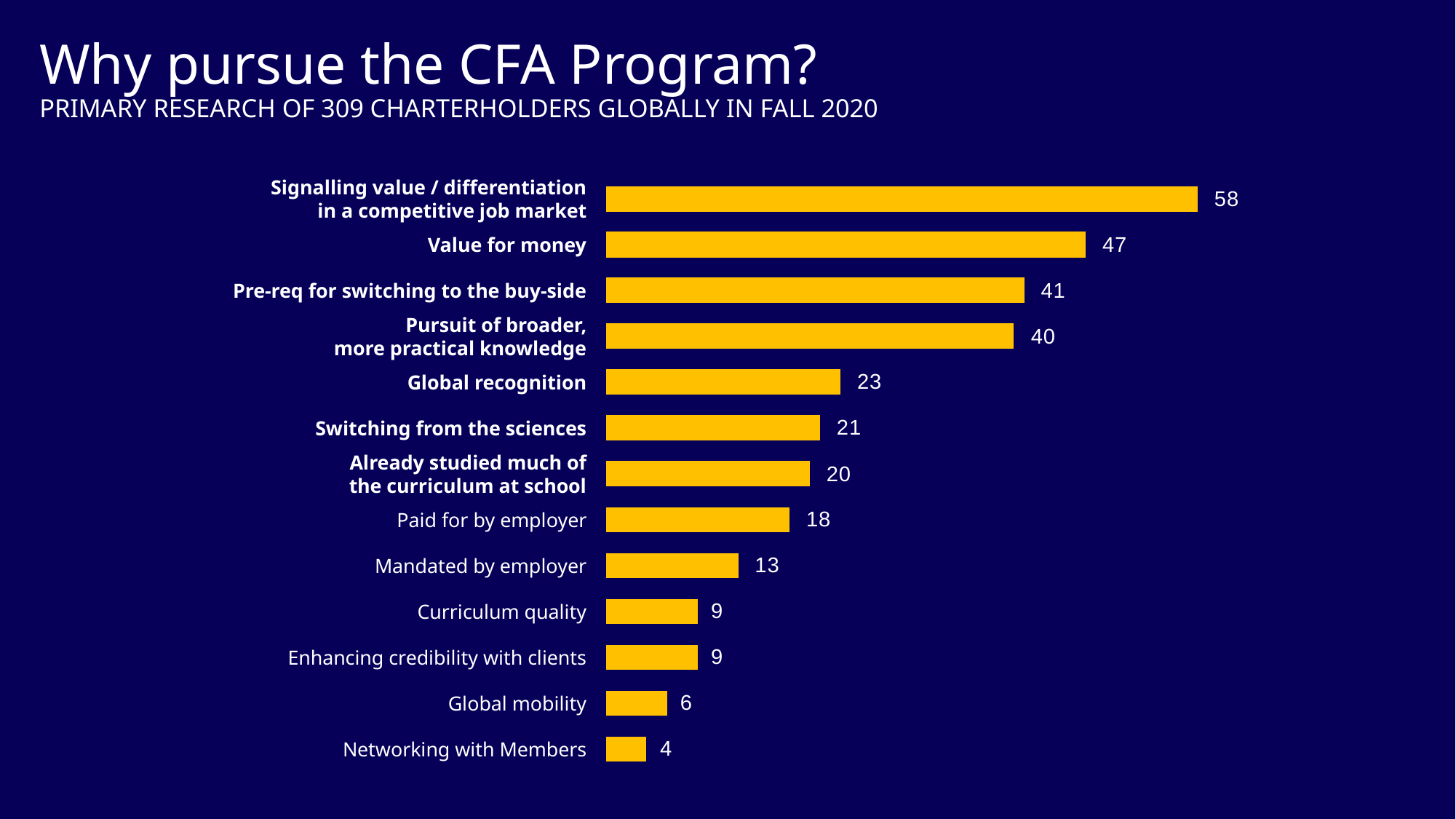
What is the value for "Global recognition"? 23 Which is larger, the value for "Pre-req for switching to the buy-side" or "Pursuit of broader, more practical knowledge"? Pre-req for switching to the buy-side What is the value for "Mandated by employer"? 13 What kind of chart is shown on the slide? Bar chart How many categories are shown in the chart? 13 What is the difference between the values for "Signalling value / differentiation in a competitive job market" and "Value for money"? 11 Which is larger, the value for "Switching from the sciences" or "Paid for by employer"? Switching from the sciences What is the difference between the values for "Paid for by employer" and "Global mobility"? 12 Which category has the lowest value? Networking with Members What is the title of the slide? Why pursue the CFA Program? What is the value for "Value for money"? 47 Which category has the highest value? Signalling value / differentiation in a competitive job market